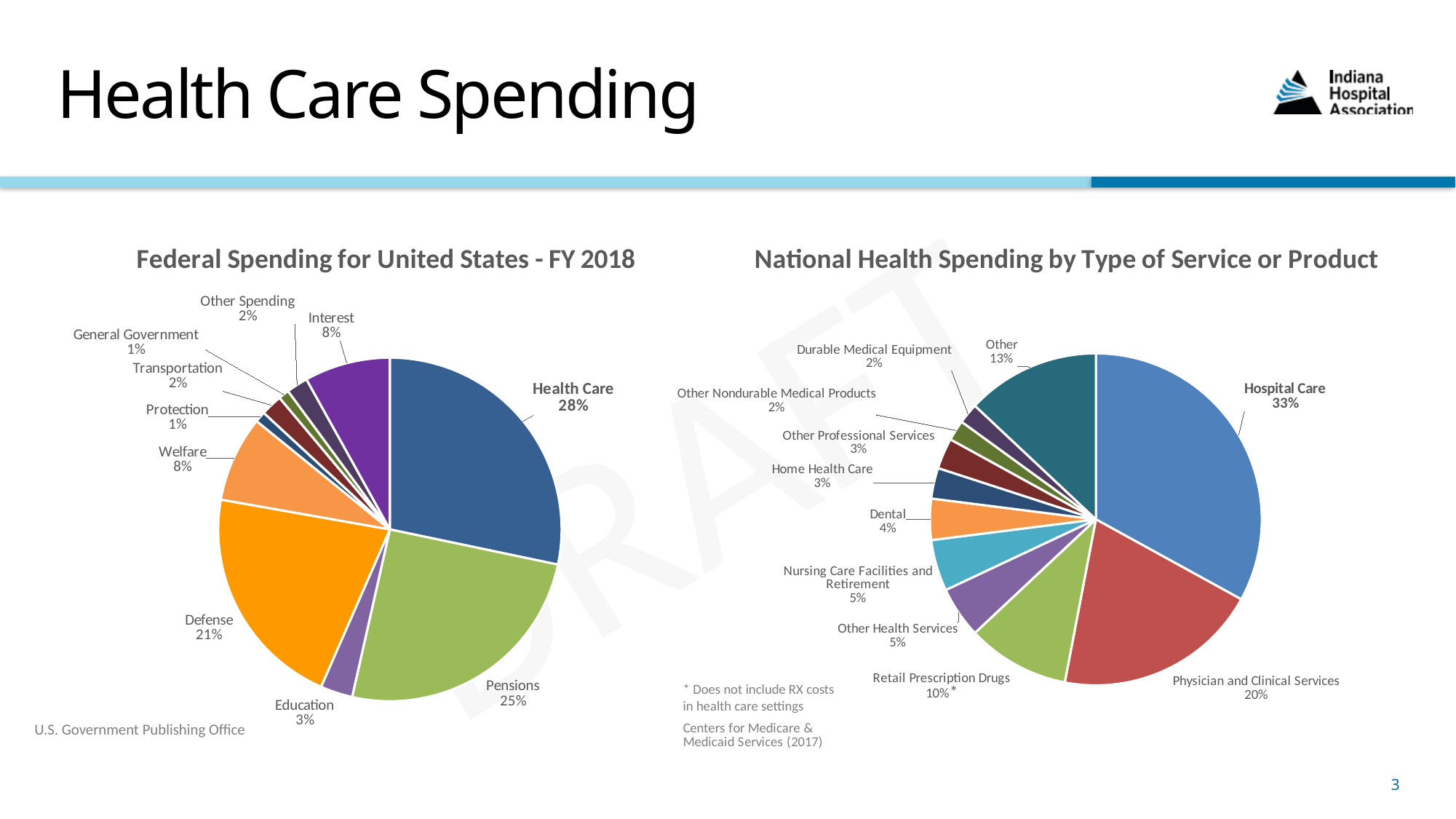
In the 'Federal Spending for United States - FY 2018' chart, which category has the largest share? Health Care In the 'Federal Spending for United States - FY 2018' chart, what is the difference between the Pensions share and the Education share? 22% What type of chart is 'Federal Spending for United States - FY 2018'? Pie chart In the 'National Health Spending by Type of Service or Product' chart, what is the value for Retail Prescription Drugs? 10% In the 'Federal Spending for United States - FY 2018' chart, what share of spending goes to Health Care? 28% In the 'Federal Spending for United States - FY 2018' chart, which is larger, Welfare or Transportation? Welfare In the 'National Health Spending by Type of Service or Product' chart, what share is Hospital Care? 33% In the 'National Health Spending by Type of Service or Product' chart, which category has the largest share? Hospital Care In the 'Federal Spending for United States - FY 2018' chart, what is the value for Defense? 21% How many categories are shown in the 'National Health Spending by Type of Service or Product' chart? 11 How many categories are shown in the 'Federal Spending for United States - FY 2018' chart? 10 In the 'National Health Spending by Type of Service or Product' chart, what is the difference between Hospital Care and Physician and Clinical Services? 13%